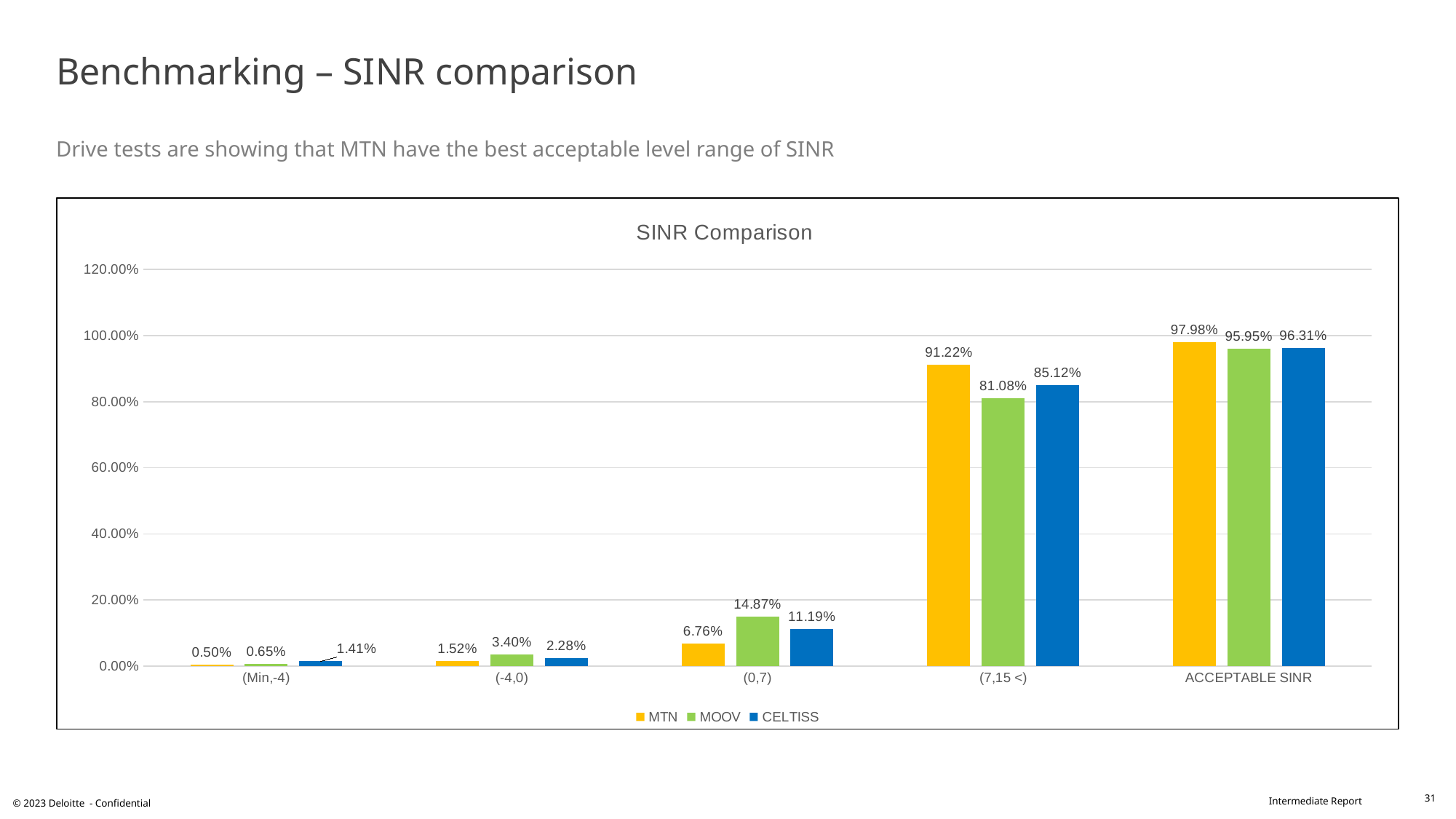
What is the value for MOOV in the (0,7) category? 14.87% Which series has the lowest value in the (Min,-4) category? MTN Which series has the highest value in the ACCEPTABLE SINR category? MTN How many series does the legend list? 3 Is the value for CELTISS in the (7,15 <) category greater or less than 80.00%? greater What is the difference between the MTN and MOOV values in the (7,15 <) category? 10.14% What is the value for CELTISS in the ACCEPTABLE SINR category? 96.31% How many categories are shown on the x axis? 5 Which is larger in the (-4,0) category: the MOOV value or the CELTISS value? MOOV What is the title of the chart? SINR Comparison What is the value for MTN in the (7,15 <) category? 91.22% What kind of chart is shown on the slide? Bar chart